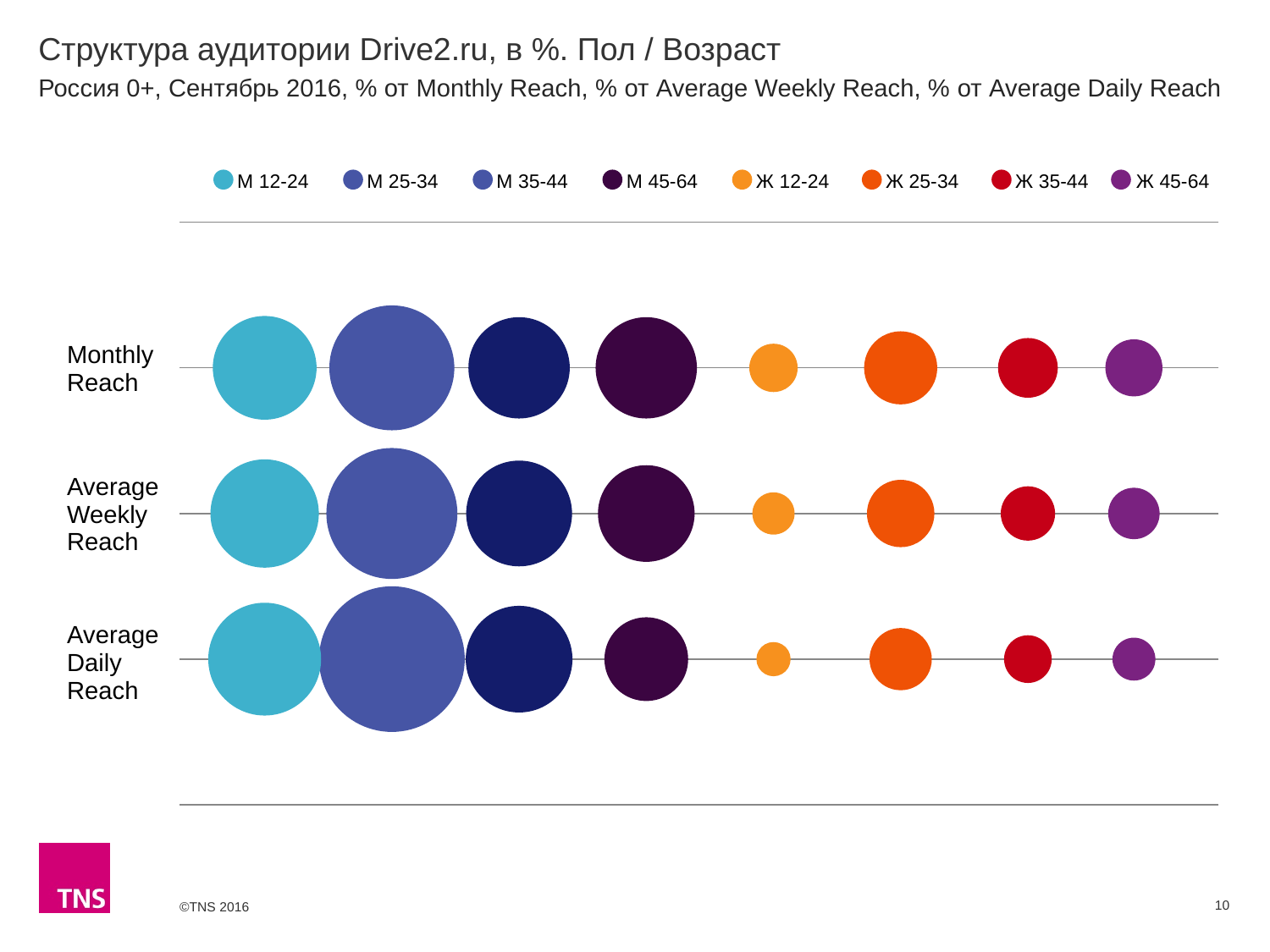
In the Average Weekly Reach row, which bubble is larger: Ж 25-34 or Ж 35-44? Ж 25-34 Among the female (Ж) groups in the Average Daily Reach row, which has the largest bubble? Ж 25-34 Which gender/age group has the largest bubble in the Monthly Reach row? М 25-34 Which gender/age group has the largest bubble in the Average Weekly Reach row? М 25-34 In the Average Daily Reach row, which bubble is larger: М 35-44 or М 45-64? М 35-44 What is the title of the chart on the slide? Структура аудитории Drive2.ru, в %. Пол / Возраст How many series does the legend list? 8 In the Monthly Reach row, which bubble is larger: М 12-24 or Ж 12-24? М 12-24 Which month and year does the chart's subtitle refer to? Сентябрь 2016 How many reach categories (rows) are plotted in the chart? 3 What kind of chart is shown on the slide? bubble chart